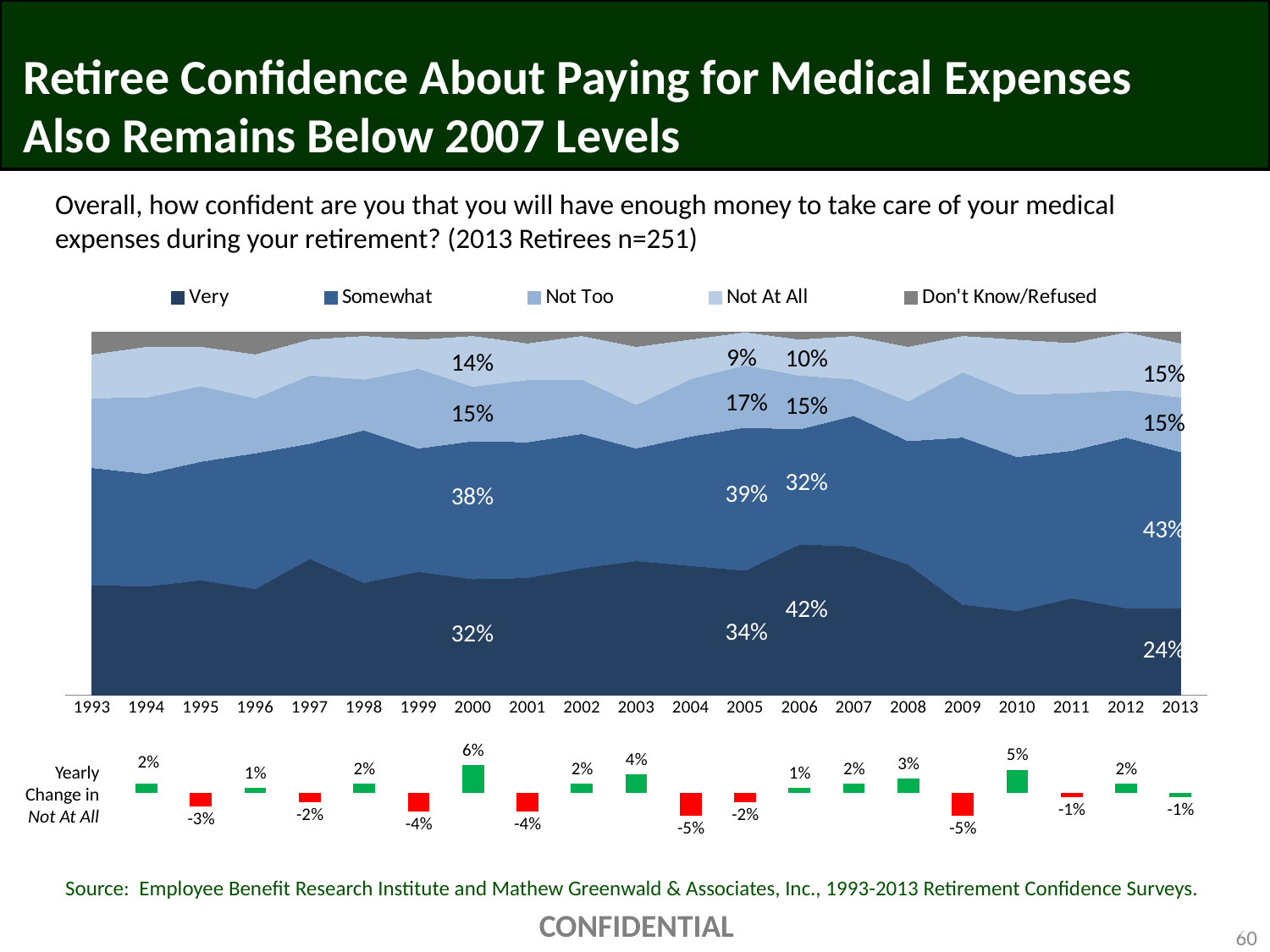
In the 'Yearly Change in Not At All' bar chart, what is the value for 2000? 6% In the 'Yearly Change in Not At All' bar chart, what is the value for 2009? -5% In the 'Yearly Change in Not At All' bar chart, which year has the highest value? 2000 In the stacked area chart, how many series does the legend list? 5 In the 'Yearly Change in Not At All' bar chart, how many years are plotted? 20 In the stacked area chart, what percentage of retirees were 'Somewhat' confident in 2000? 38% In the stacked area chart, what is the difference between the 'Very' share in 2006 and the 'Very' share in 2013? 18% In the stacked area chart, what percentage of retirees were 'Not At All' confident in 2005? 9% In the stacked area chart, what percentage of retirees were 'Very' confident in 2013? 24% What kind of chart is the 'Yearly Change in Not At All' chart at the bottom of the slide? Bar chart In the stacked area chart, what percentage of retirees were 'Very' confident in 2006? 42% In the stacked area chart, which is larger in 2013: the 'Very' share or the 'Somewhat' share? Somewhat